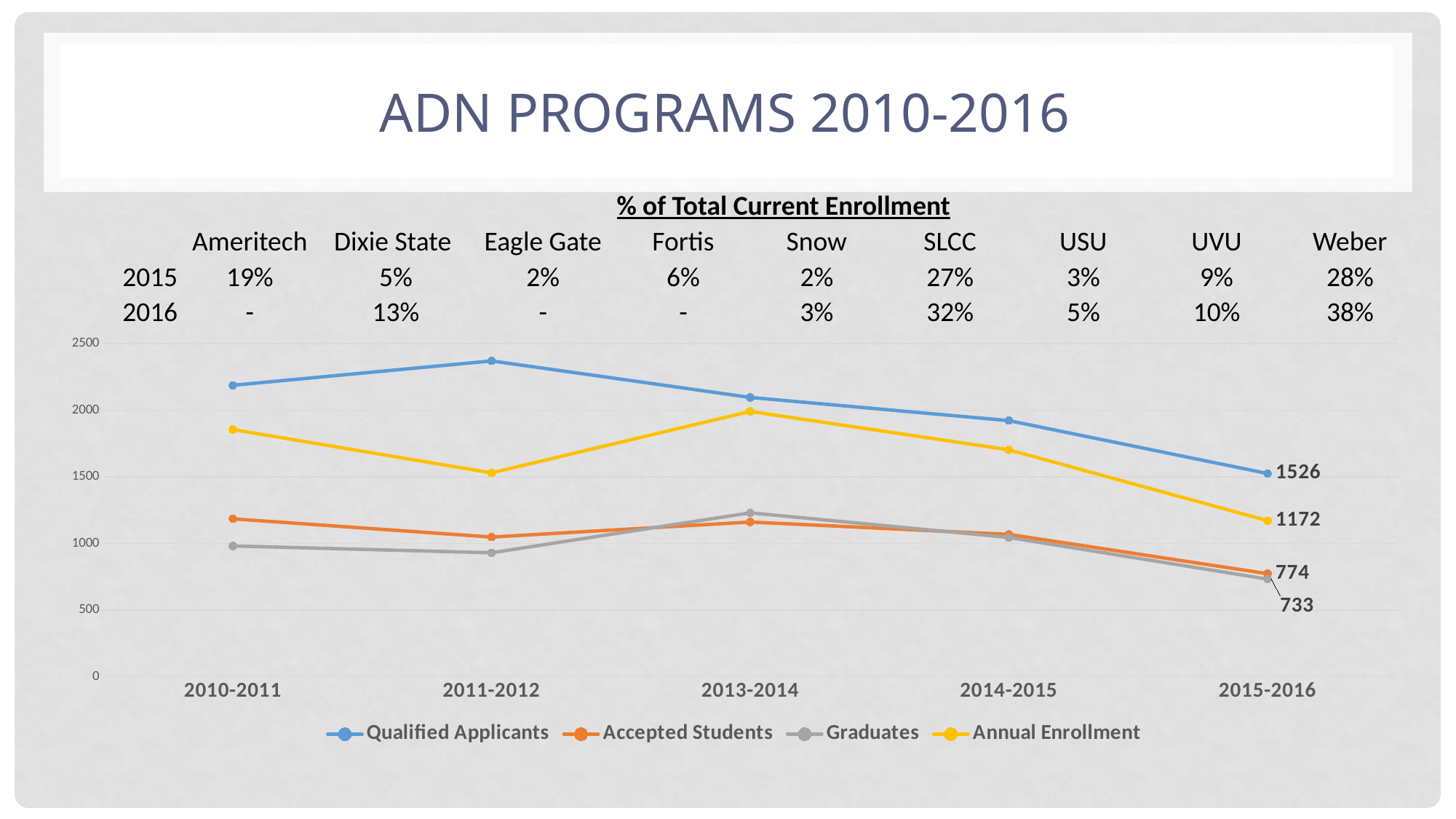
What is the difference between Qualified Applicants and Annual Enrollment in 2015-2016? 354 What kind of chart is shown on the slide? line chart Is the value for Qualified Applicants in 2011-2012 greater or less than 2000? greater How many series does the chart legend list? 4 What is the value for Accepted Students in 2015-2016? 774 What is the value for Qualified Applicants in 2015-2016? 1526 Is the value for Graduates in 2011-2012 greater or less than 1000? less What is the value for Graduates in 2015-2016? 733 What is the difference between Accepted Students and Graduates in 2015-2016? 41 Which series has the highest value in 2015-2016? Qualified Applicants How many academic-year categories are shown on the x axis of the chart? 5 What is the value for Annual Enrollment in 2015-2016? 1172